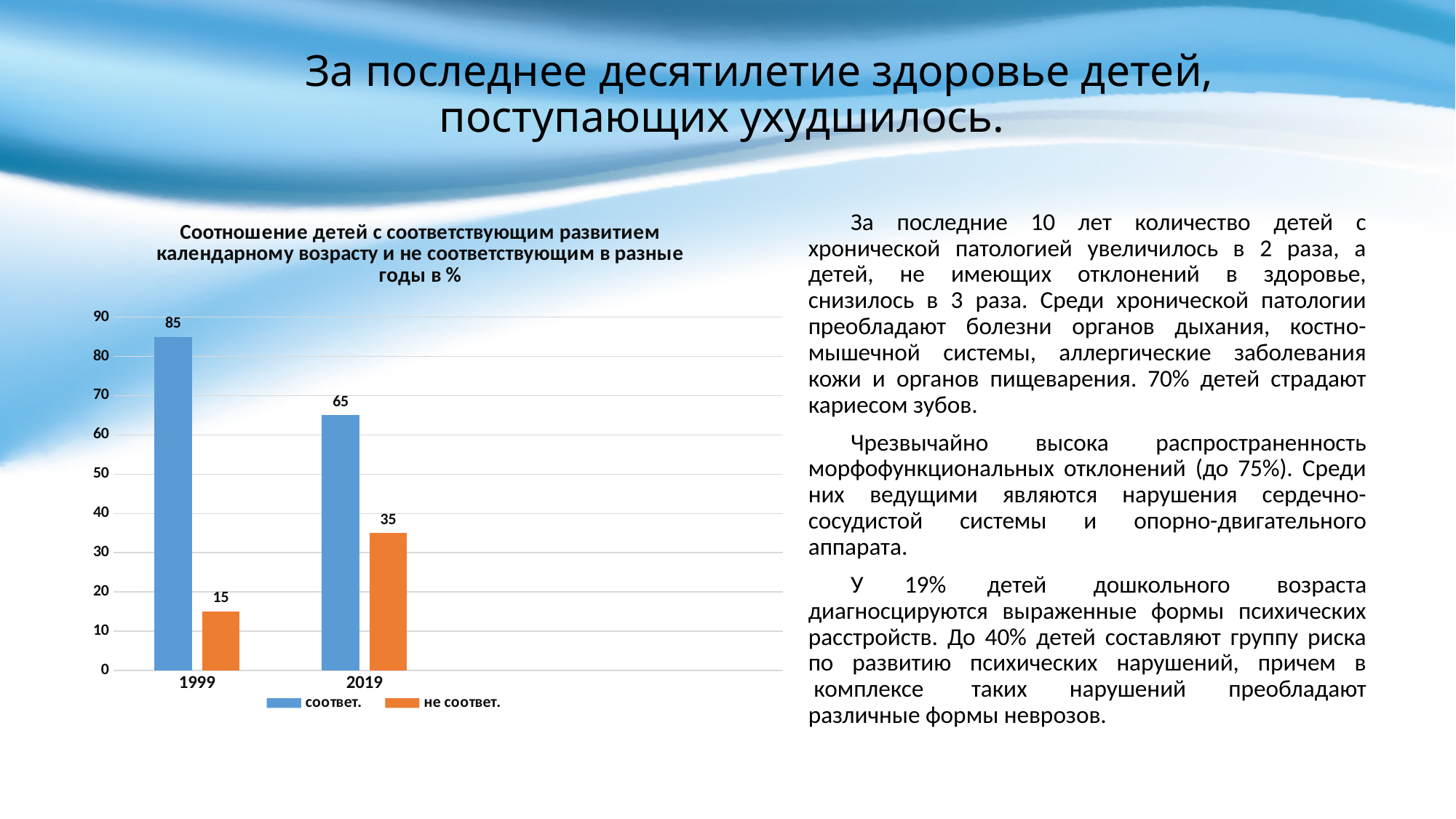
What is the value for "соответ." in 2019? 65 Which year has the highest value for "соответ."? 1999 What is the difference between the "соответ." values for 1999 and 2019? 20 Which year has the lowest value for "не соответ."? 1999 How many series does the legend list? 2 How many years are shown on the x axis? 2 What is the value for "не соответ." in 1999? 15 Does the "соответ." series rise or fall from 1999 to 2019? fall Which is larger: "не соответ." in 2019 or "не соответ." in 1999? не соответ. in 2019 What kind of chart is shown on the slide? bar chart What is the value for "не соответ." in 2019? 35 What is the value for "соответ." in 1999? 85